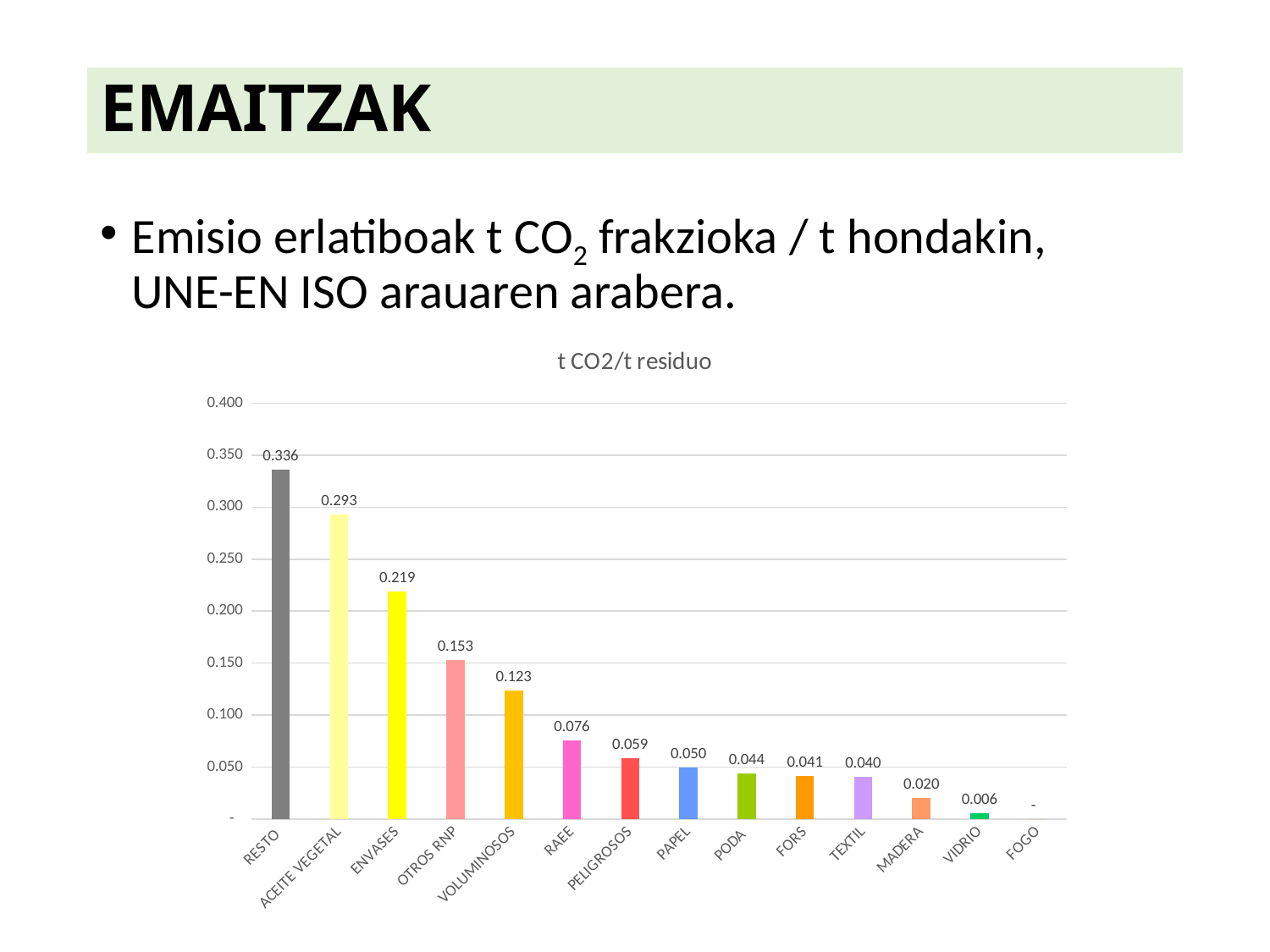
Which category has the highest value? RESTO What is the title of the chart? t CO2/t residuo Which is larger, the value for OTROS RNP or the value for RAEE? OTROS RNP What type of chart is shown on the slide? Bar chart What is the value for VOLUMINOSOS? 0.123 What is the value for ENVASES? 0.219 What is the difference between the values for RESTO and ACEITE VEGETAL? 0.043 How many categories are shown on the x axis? 14 Which category has the lowest non-zero value shown with a numeric label? VIDRIO What is the value for RESTO? 0.336 What is the value for MADERA? 0.020 Do the values rise or fall moving from left to right along the x axis? Fall